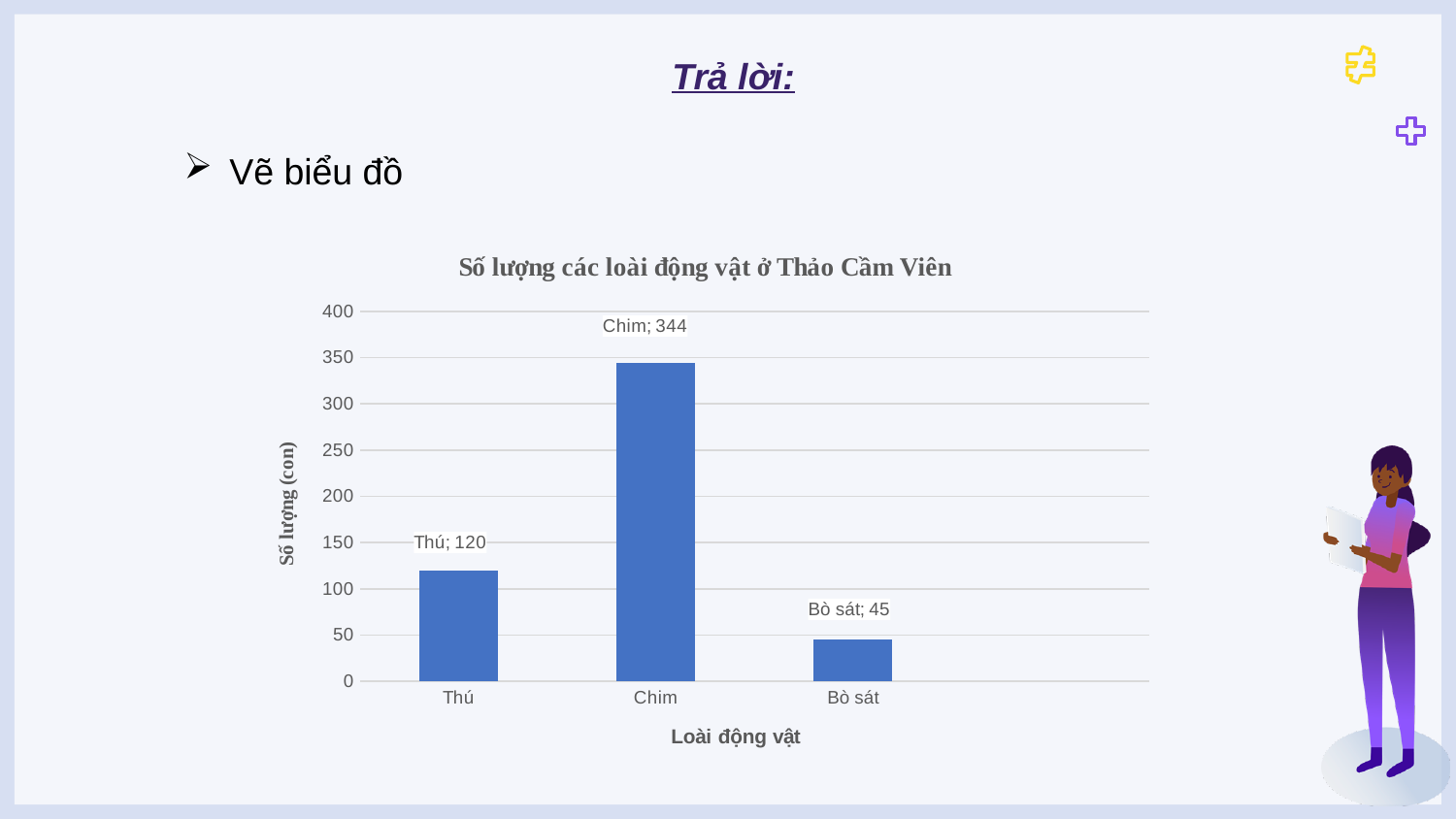
What is the value for Chim? 344 What is the difference between the values for Chim and Thú? 224 Is the value for Chim greater or less than 300? greater What kind of chart is shown on the slide? bar chart What is the value for Thú? 120 What is the value for Bò sát? 45 Which category has the lowest value? Bò sát How many categories are shown on the x axis? 3 Which is larger, the value for Thú or the value for Bò sát? Thú What is the title of the chart? Số lượng các loài động vật ở Thảo Cầm Viên Which category has the highest value? Chim What is the difference between the values for Thú and Bò sát? 75